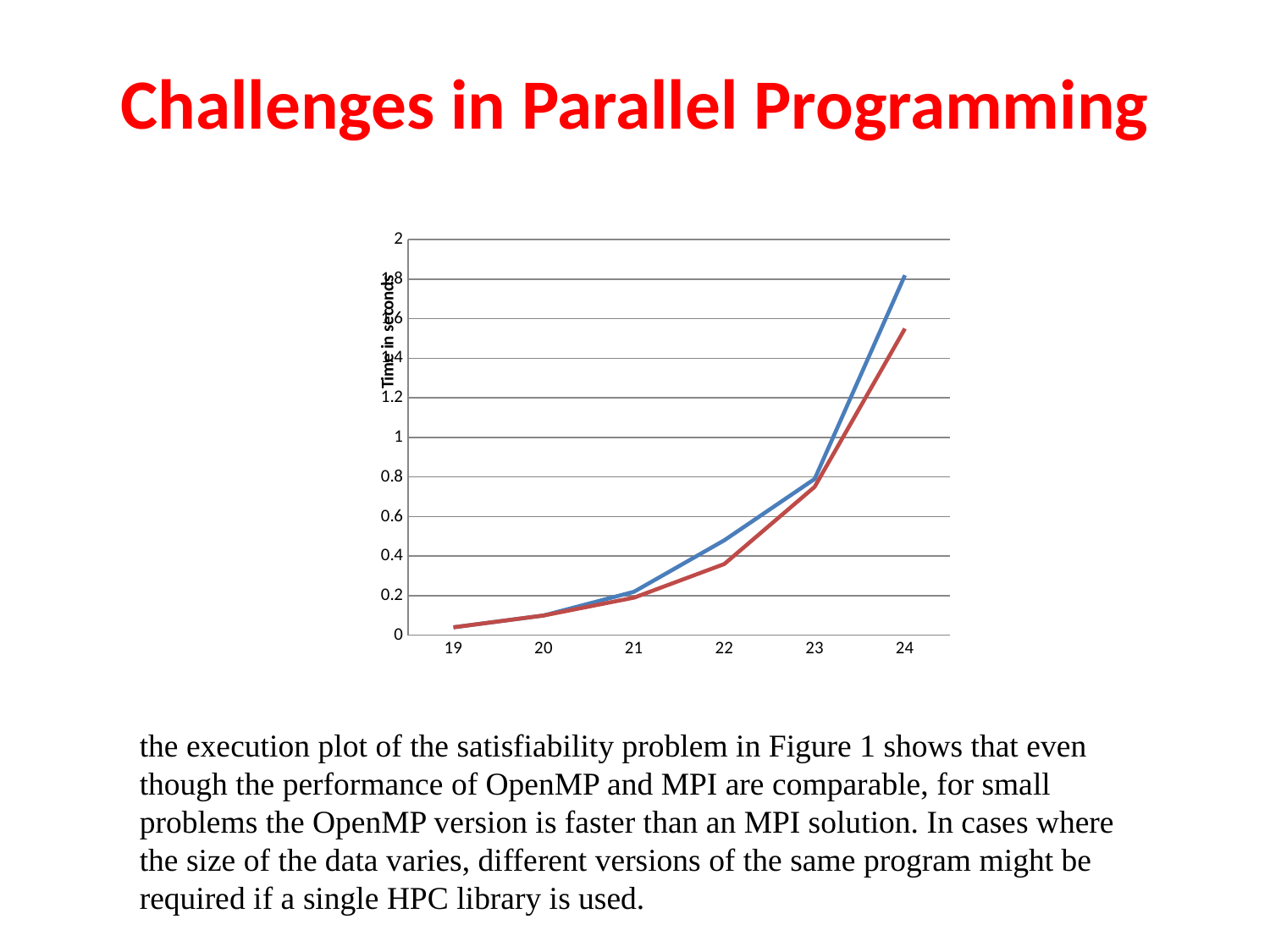
At which x-axis value is the red line at its lowest? 19 Do the values of the blue line rise or fall as the x axis goes from 19 to 24? rise At which x-axis value does the blue line reach its highest point? 24 Is the value of the blue line at 23 greater or less than 1? less Is the value of the red line at 22 greater or less than 0.4? less At x = 24, which line has the higher value, the blue line or the red line? the blue line How many points are marked along the x axis of the chart? 6 How many lines are plotted on the chart? 2 Is the value of the blue line at 24 greater or less than 1.6? greater What is the title of the y axis of the chart? Time in seconds What kind of chart is shown on the slide? line chart